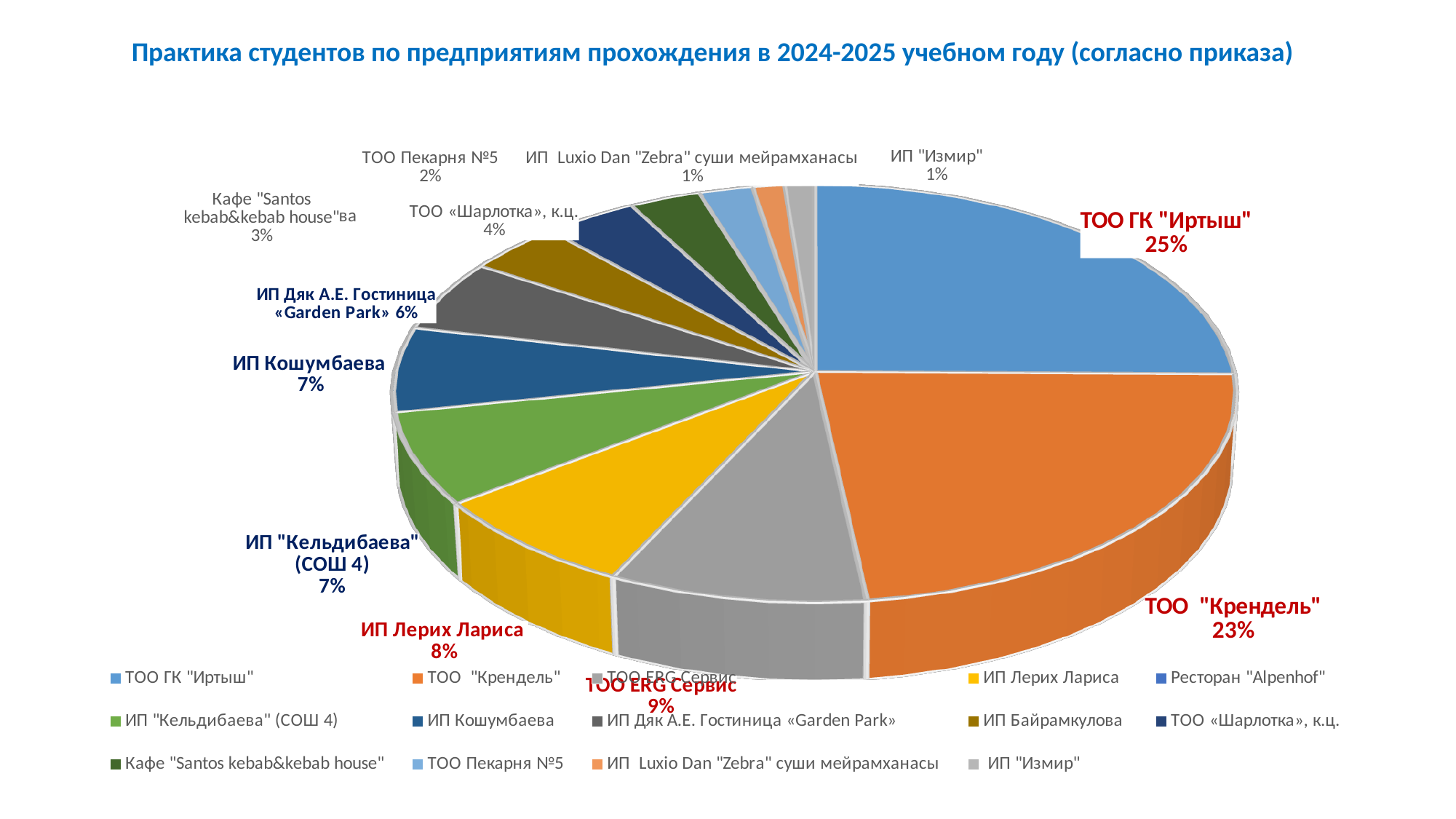
Which has a larger share: ИП Кошумбаева or ТОО Пекарня №5? ИП Кошумбаева What is the title of the chart? Практика студентов по предприятиям прохождения в 2024-2025 учебном году (согласно приказа) Which enterprise has the largest share of the pie? ТОО ГК "Иртыш" What share of the pie does ТОО "Крендель" have? 23% How many enterprises are listed in the legend? 14 What is the value shown for ТОО «Шарлотка», к.ц.? 4% What is the value shown for ИП Дяк А.Е. Гостиница «Garden Park»? 6% What is the value shown for ИП Лерих Лариса? 8% What share of the pie does ТОО ГК "Иртыш" have? 25% What is the value shown for ТОО ERG Сервис? 9% What is the difference in percentage points between ТОО ГК "Иртыш" and ТОО "Крендель"? 2 What kind of chart is shown on the slide? pie chart